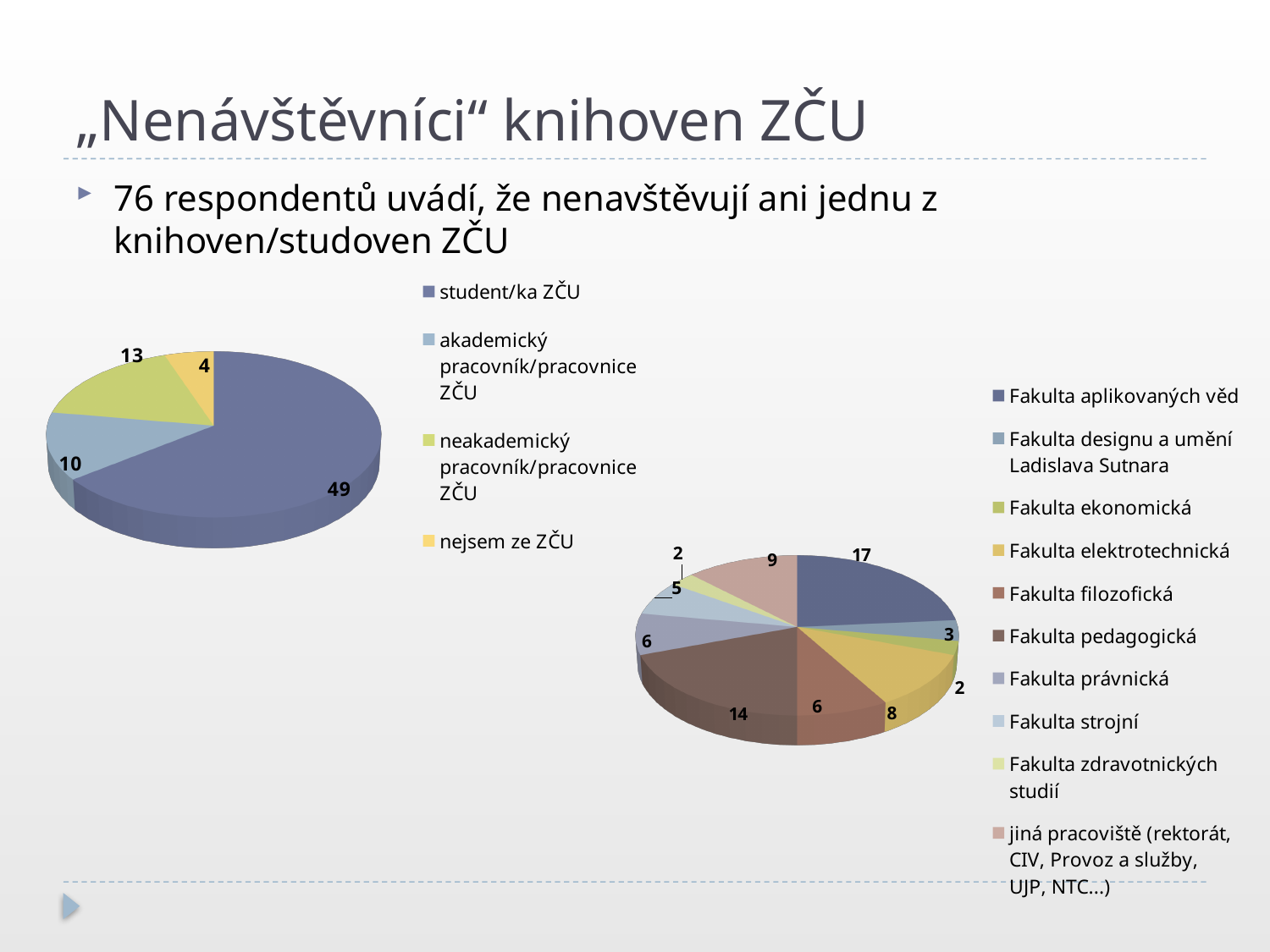
In the left pie chart, which category has the largest slice? student/ka ZČU In the left pie chart, what is the total of all slices? 76 In the left pie chart, what is the value for nejsem ze ZČU? 4 In the right pie chart, what is the value for Fakulta pedagogická? 14 In the right pie chart, which is larger: Fakulta strojní or jiná pracoviště (rektorát, CIV, Provoz a služby, UJP, NTC...)? jiná pracoviště (rektorát, CIV, Provoz a služby, UJP, NTC...) What type of chart is shown on the right of the slide? pie chart In the left pie chart, what is the value for student/ka ZČU? 49 How many categories does the legend of the right pie chart list? 10 In the right pie chart, what is the value for Fakulta elektrotechnická? 8 How many categories does the legend of the left pie chart list? 4 In the left pie chart, what is the difference between the values for neakademický pracovník/pracovnice ZČU and akademický pracovník/pracovnice ZČU? 3 In the right pie chart, which faculty has the largest slice? Fakulta aplikovaných věd